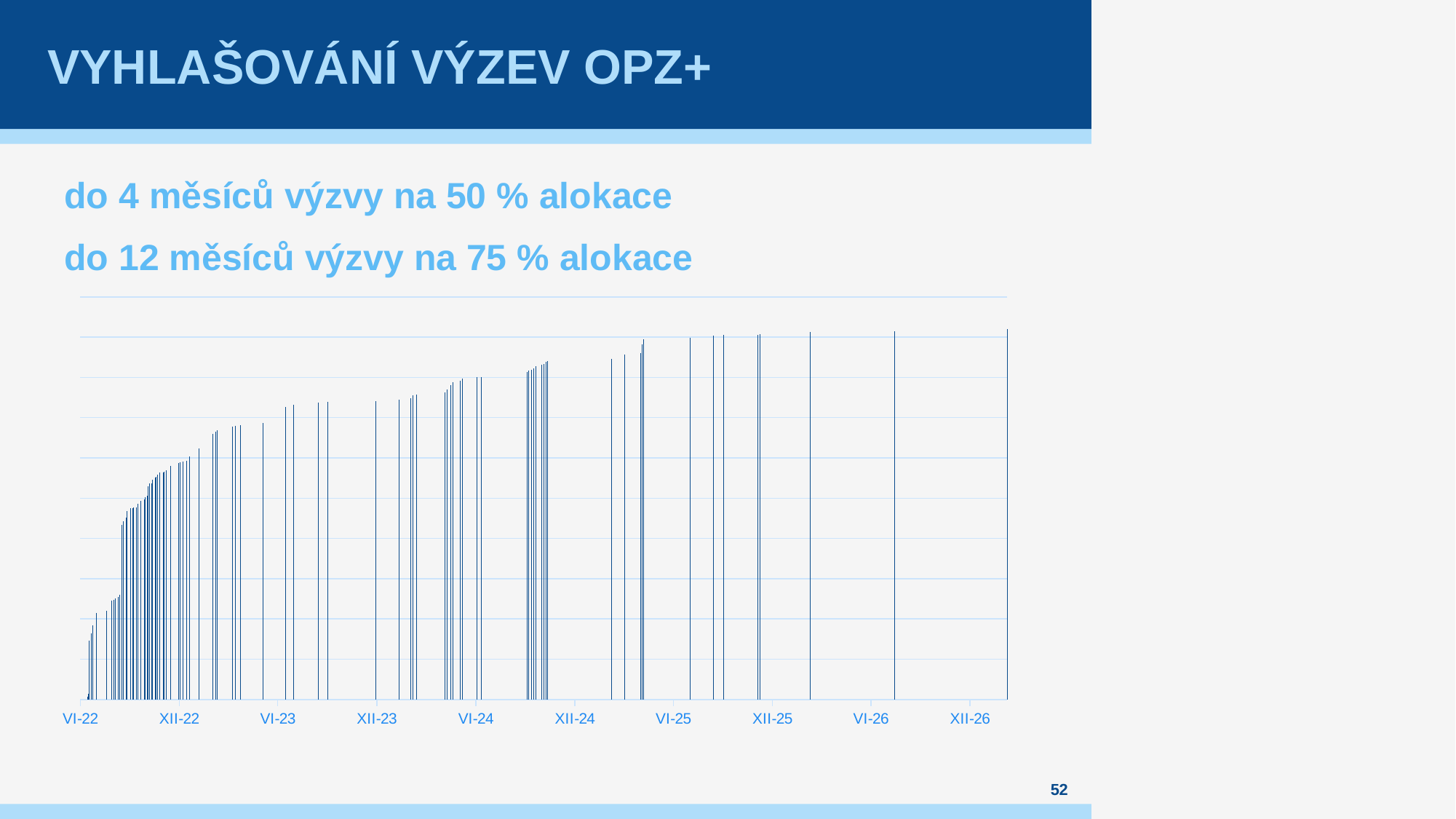
Which is taller: the bar at XII-26 or the bar at VI-22? XII-26 Which is taller: the bar at VI-25 or the bar at VI-23? VI-25 What is the first label on the x axis of the chart? VI-22 How many labels are shown on the x axis of the chart? 10 Do the bar heights generally rise or fall from left to right along the x axis? rise What kind of chart is shown on the slide? bar chart Which is shorter: the bar at XII-22 or the bar at XII-24? XII-22 What is the last label on the x axis of the chart? XII-26 Does the chart display a legend? No